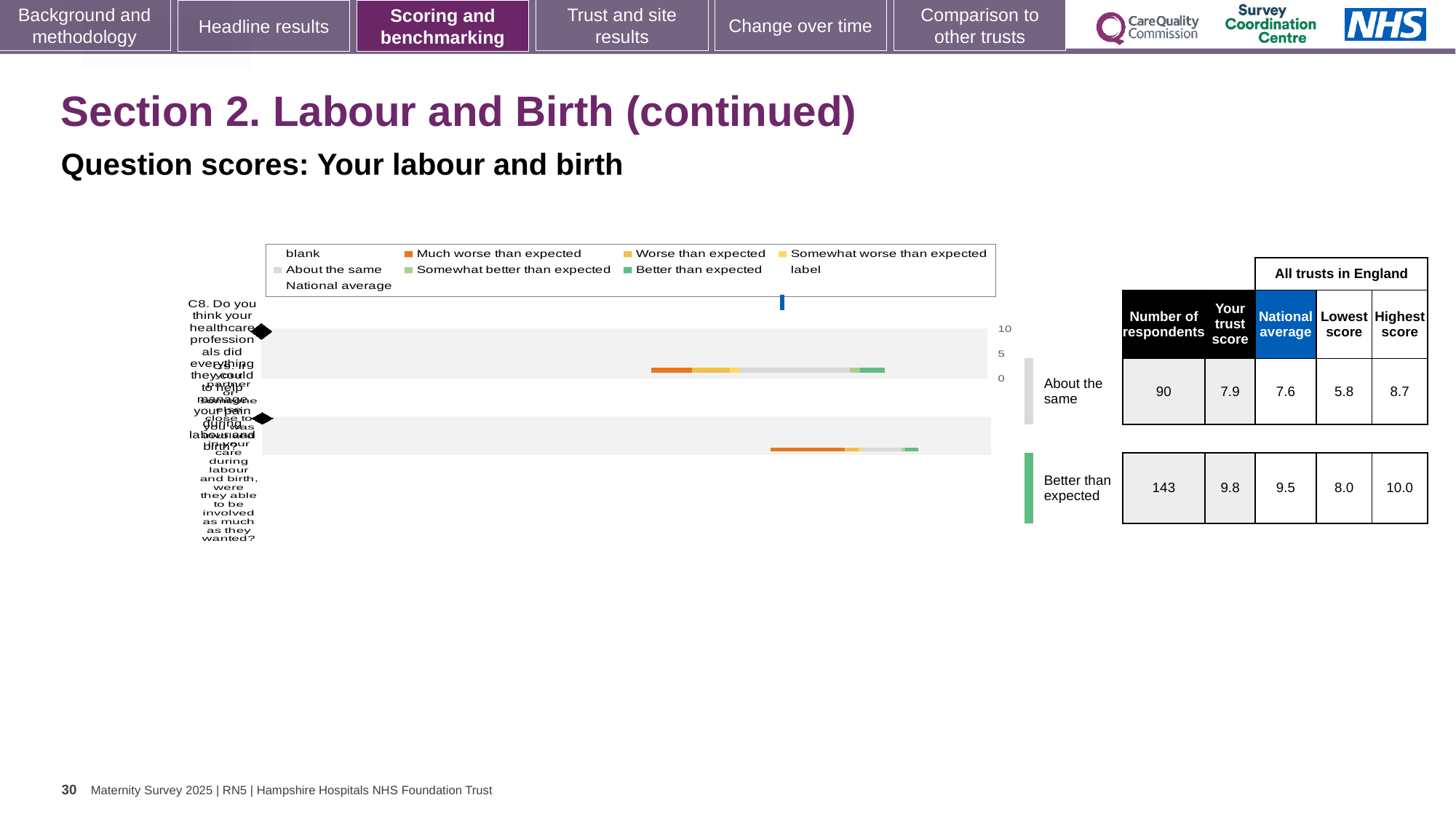
In the table next to the chart, what is the lowest score for the 'About the same' row? 5.8 In the table next to the chart, which row has more respondents, 'About the same' or 'Better than expected'? Better than expected In the table next to the chart, what is the number of respondents for the 'About the same' row? 90 In the table next to the chart, what is the difference between 'Your trust score' and the national average for the 'Better than expected' row? 0.3 In the table next to the chart, what is the highest score for the 'Better than expected' row? 10.0 In the chart legend, what colour represents 'Much worse than expected'? orange In the chart legend, what colour represents 'Better than expected'? green How many bars (question rows) are plotted in the chart? 2 What kind of chart is shown on the slide? bar chart In the table next to the chart, what is the national average for the 'About the same' row? 7.6 In the table next to the chart, what is the difference between the highest score and the lowest score for the 'About the same' row? 2.9 In the table next to the chart, what is 'Your trust score' for the 'Better than expected' row? 9.8